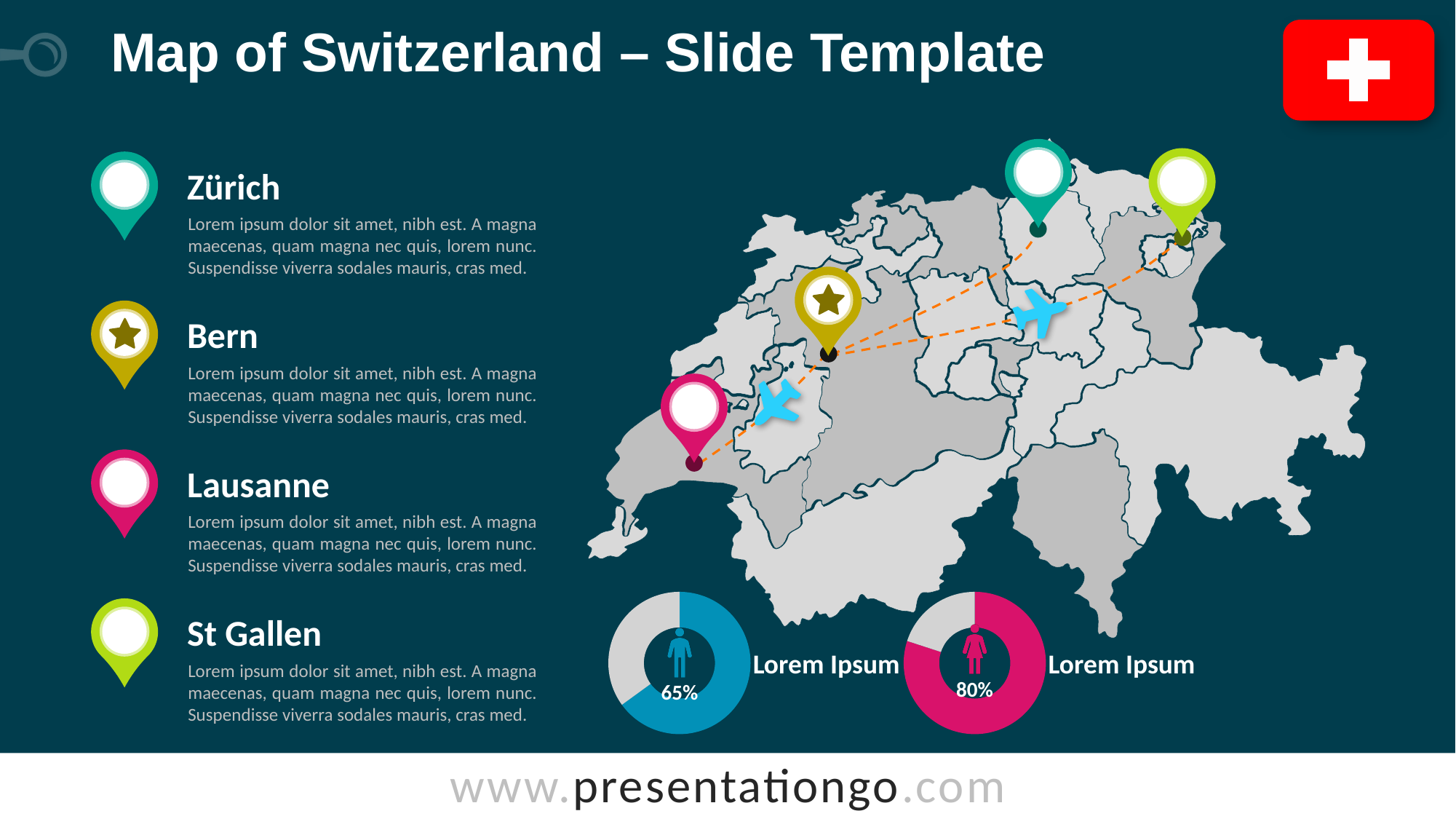
What value is shown in the left donut chart with the male icon? 65% Which donut chart shows the smaller value, the left one with the male icon or the right one with the female icon? the left one with the male icon Is the value in the right donut chart with the female icon greater or less than 75%? greater Is the value in the left donut chart with the male icon greater or less than 50%? greater What value is shown in the right donut chart with the female icon? 80% How many donut charts are shown at the bottom of the slide? 2 What label appears next to the right donut chart with the female icon? Lorem Ipsum Which donut chart shows the larger value, the left one with the male icon or the right one with the female icon? the right one with the female icon What colour is the filled portion of the left donut chart with the male icon? blue What is the difference between the value in the right donut chart (80%) and the value in the left donut chart (65%)? 15% What kind of chart is used to display the 65% and 80% values at the bottom of the slide? donut chart